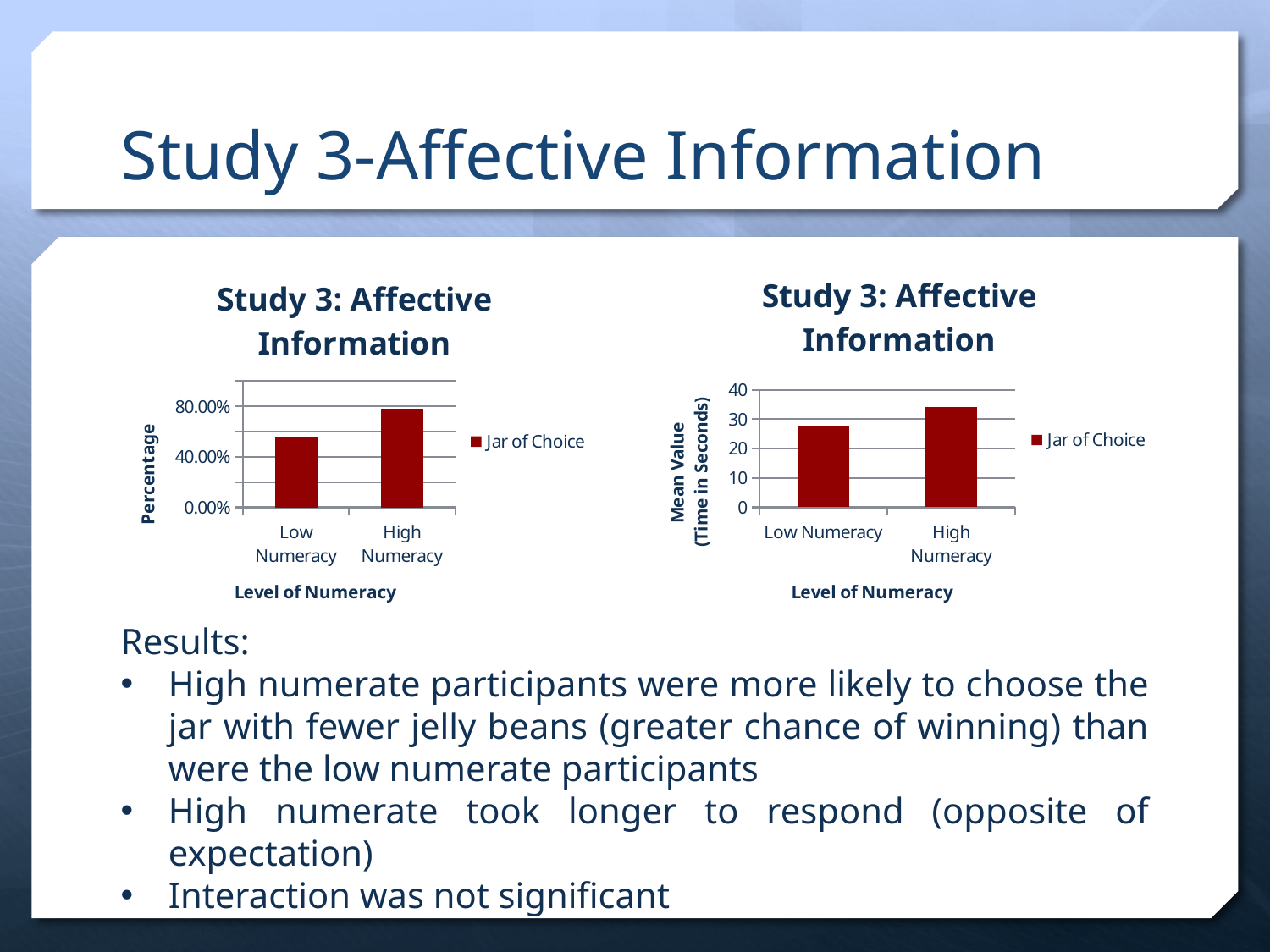
In the left chart (Percentage), is the value for Low Numeracy greater or less than 40.00%? greater What is the legend entry shown in the right chart (Mean Value in seconds)? Jar of Choice What kind of chart is the left chart (with the Percentage axis)? bar chart In the right chart (Mean Value in seconds), is the value for Low Numeracy greater or less than 30? less What is the x-axis title of the left chart (Percentage)? Level of Numeracy In the right chart (Mean Value in seconds), which level of numeracy has the lowest bar? Low Numeracy How many categories are shown on the x axis of the right chart (Mean Value in seconds)? 2 In the left chart (Percentage), which is larger, the value for Low Numeracy or High Numeracy? High Numeracy In the left chart (Percentage), which level of numeracy has the highest bar? High Numeracy In the right chart (Mean Value in seconds), is the value for High Numeracy greater or less than 30? greater How many series does the legend of the left chart (Percentage) list? 1 In the right chart (Mean Value in seconds), do the values rise or fall from Low Numeracy to High Numeracy? rise